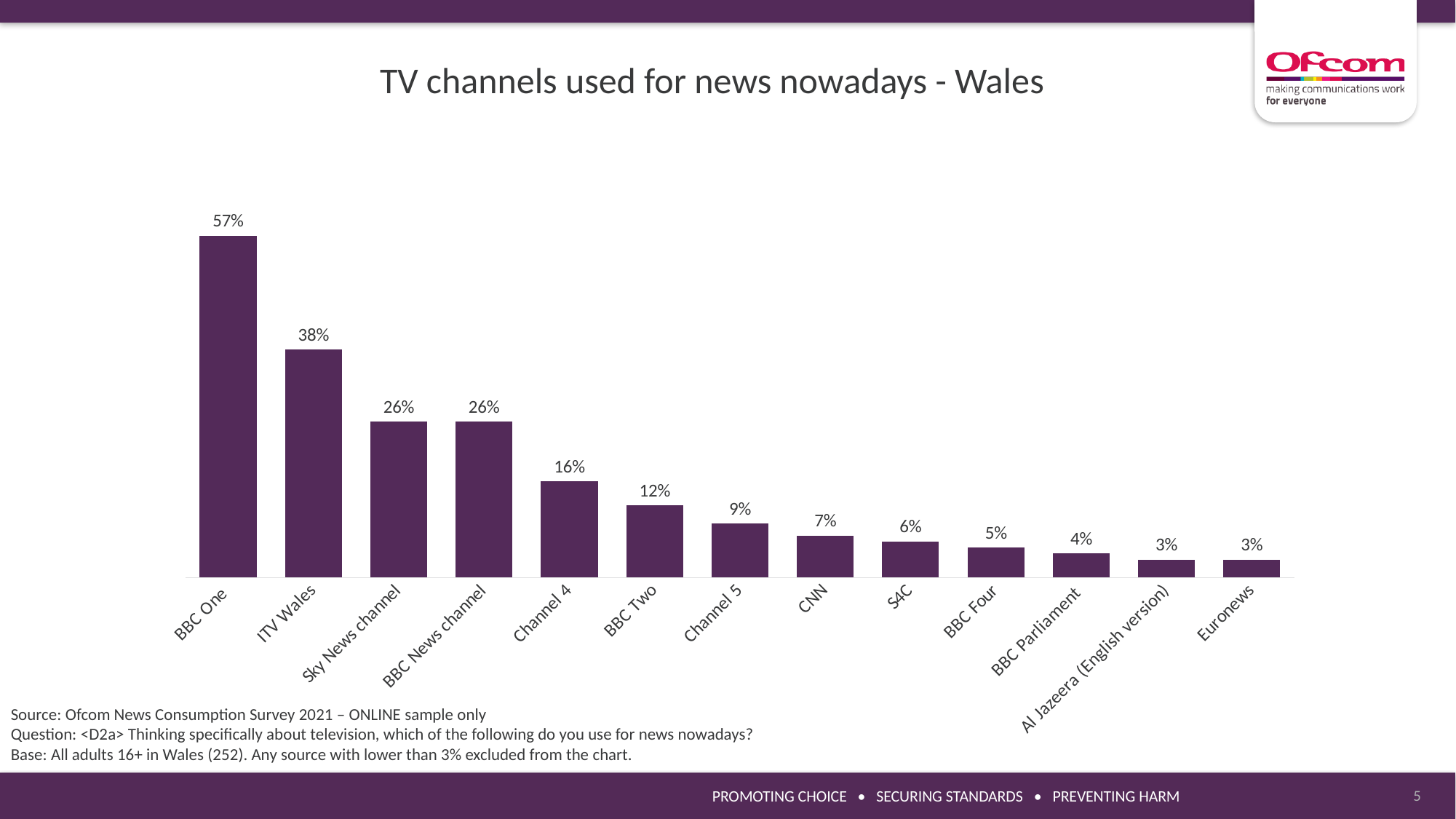
What is the value shown for ITV Wales? 38% What is the value shown for Channel 4? 16% Which TV channel has the highest value on the chart? BBC One What is the title of the chart? TV channels used for news nowadays - Wales What kind of chart is shown on the slide? Bar chart Do the values rise or fall moving from left to right along the x axis? Fall What is the value shown for S4C? 6% What is the difference between the values for BBC One and ITV Wales? 19% What is the difference between the values for Channel 4 and BBC Two? 4% Which has a larger value, Channel 5 or CNN? Channel 5 How many TV channels are shown on the chart? 13 What percentage of adults in Wales use BBC One for news nowadays? 57%